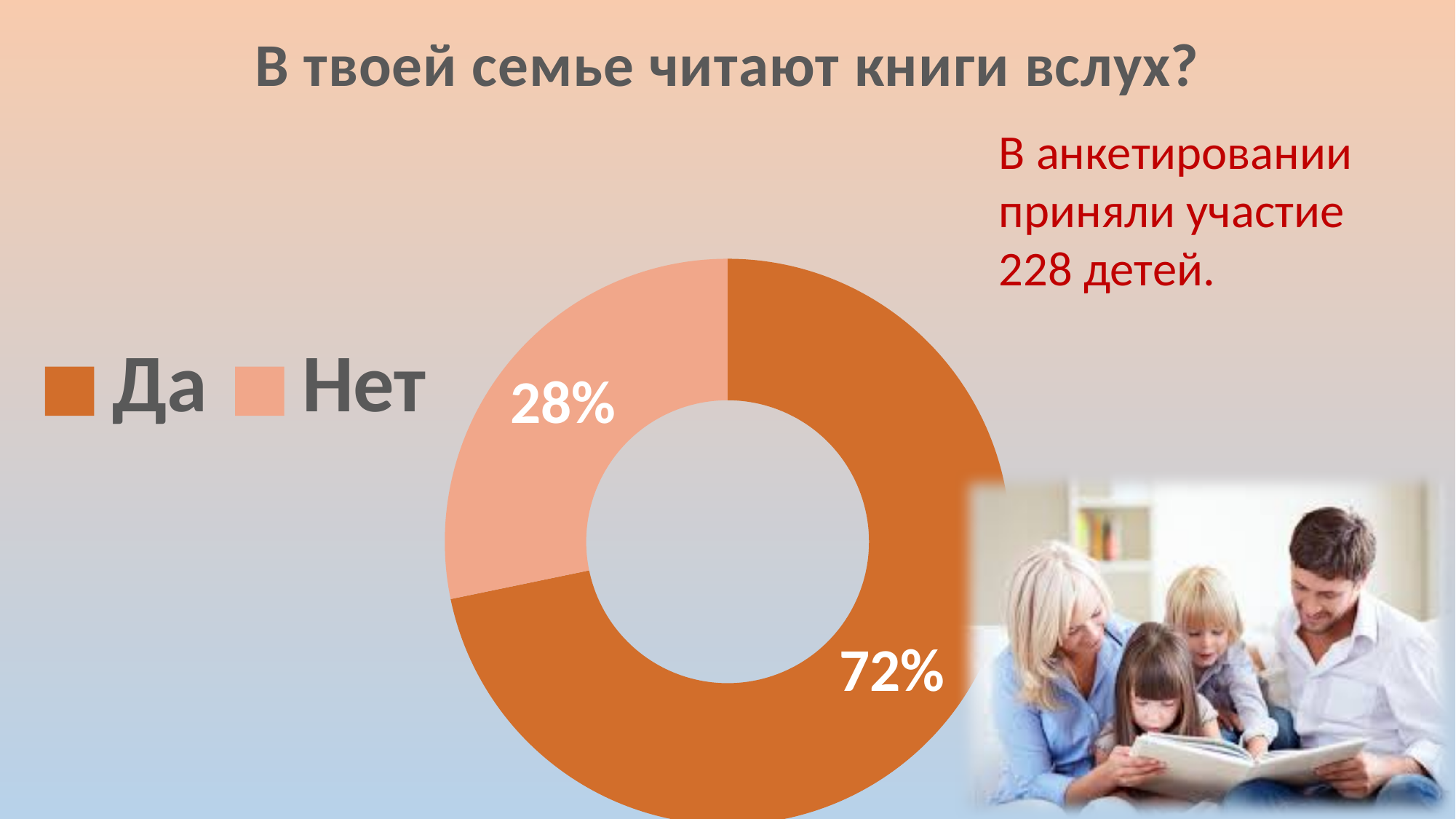
What percentage of respondents answered "Нет" (No)? 28% How many children took part in the survey, according to the text on the slide? 228 How many categories does the chart show? 2 What is the title of the slide above the chart? В твоей семье читают книги вслух? What kind of chart is shown on the slide? Doughnut (pie) chart Which answer has the largest share of the chart? Да What is the difference in percentage points between the "Да" and "Нет" shares? 44 What share of the chart does the "Нет" slice take? 28% Which answer has the smallest share of the chart? Нет Which is larger, the share for "Да" or the share for "Нет"? Да Which colour represents "Нет" in the legend? Light orange (peach) What percentage of respondents answered "Да" (Yes)? 72%